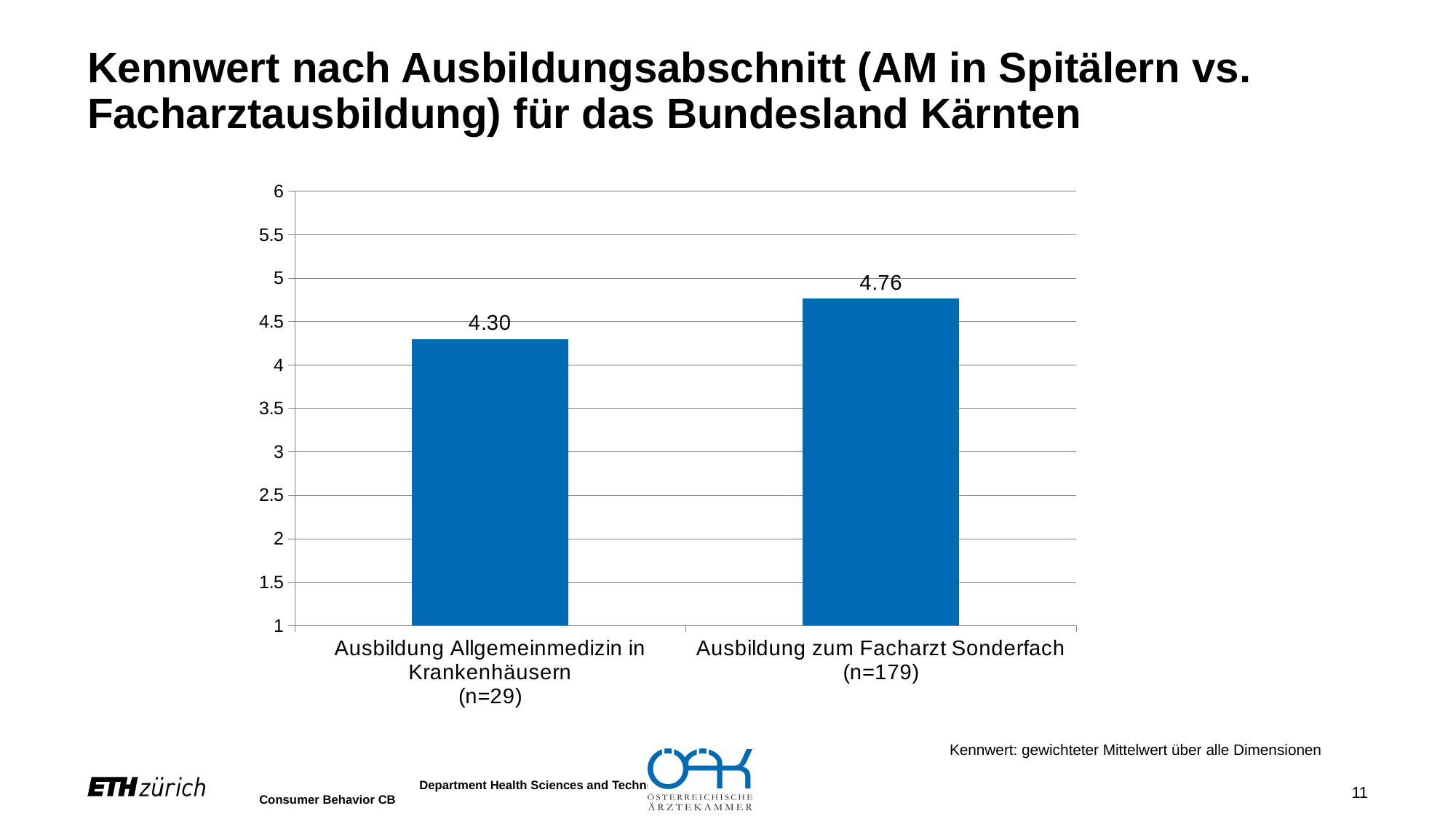
What is the value for Ausbildung zum Facharzt Sonderfach (n=179)? 4.76 Which is larger: the value for Ausbildung Allgemeinmedizin in Krankenhäusern or the value for Ausbildung zum Facharzt Sonderfach? Ausbildung zum Facharzt Sonderfach Is the value for Ausbildung zum Facharzt Sonderfach greater or less than 5? less Which category has the lowest value? Ausbildung Allgemeinmedizin in Krankenhäusern (n=29) Which category has the highest value? Ausbildung zum Facharzt Sonderfach (n=179) What is the sample size (n) given for the Ausbildung zum Facharzt Sonderfach category? 179 What is the difference between the value for Ausbildung zum Facharzt Sonderfach and the value for Ausbildung Allgemeinmedizin in Krankenhäusern? 0.46 What is the value for Ausbildung Allgemeinmedizin in Krankenhäusern (n=29)? 4.30 What is the maximum value shown on the vertical axis? 6 What kind of chart is shown on the slide? bar chart Is the value for Ausbildung Allgemeinmedizin in Krankenhäusern greater or less than 4? greater How many categories are shown in the chart? 2